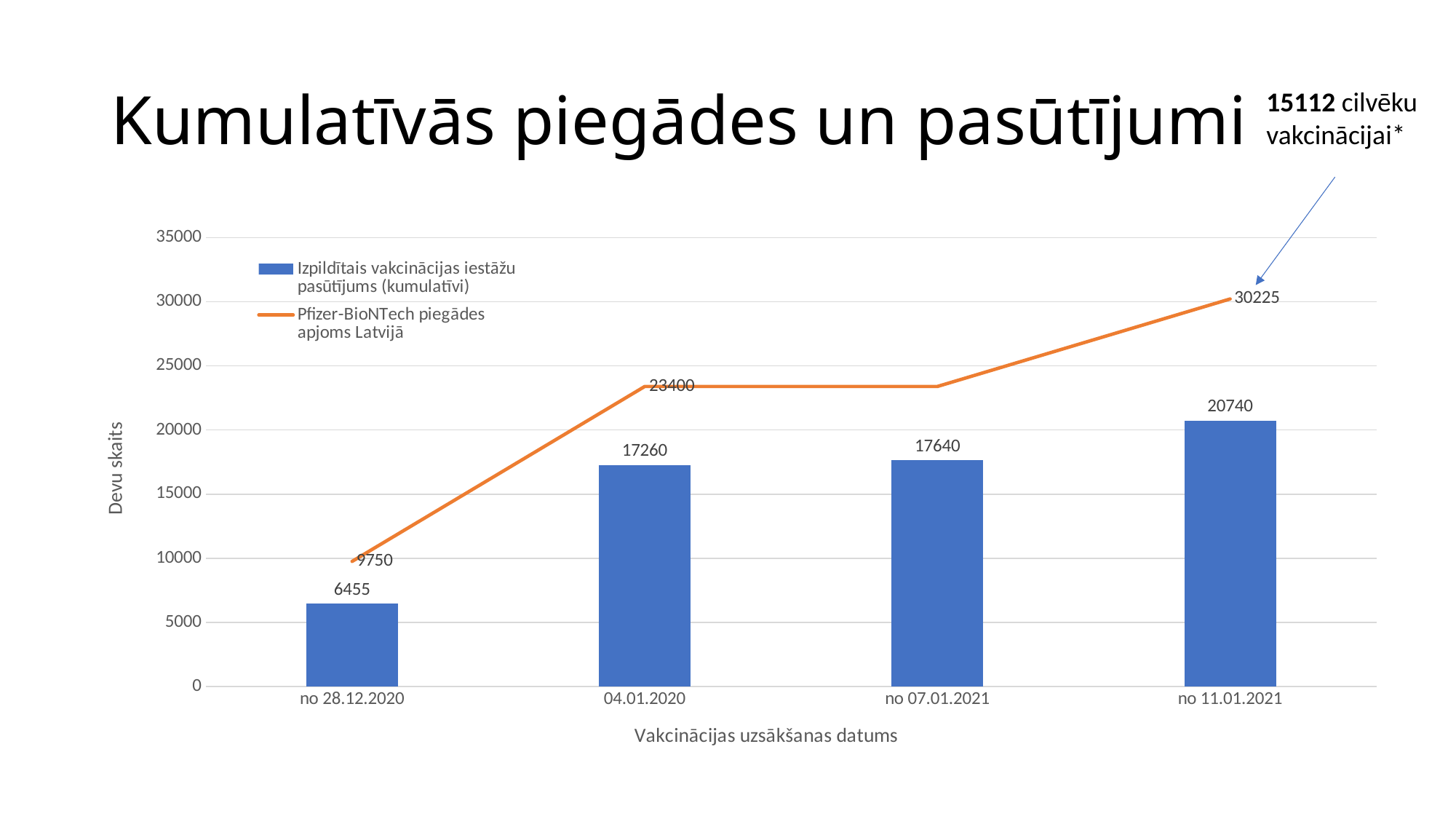
How many categories are shown on the x axis? 4 What is the difference between the bar values for 'no 11.01.2021' and 'no 07.01.2021'? 3100 What is the value of the bar for 'no 28.12.2020'? 6455 What is the value of the Pfizer-BioNTech piegādes apjoms Latvijā line at '04.01.2020'? 23400 Is the bar value for '04.01.2020' greater or less than 15000? greater At 'no 28.12.2020', which is larger: the bar value or the line value? the line value (9750) How many series does the legend list? 2 What is the label of the y axis? Devu skaits Which category has the highest bar value? no 11.01.2021 What is the value of the bar for 'no 11.01.2021'? 20740 What is the value of the Pfizer-BioNTech piegādes apjoms Latvijā line at 'no 11.01.2021'? 30225 Which category has the lowest bar value? no 28.12.2020